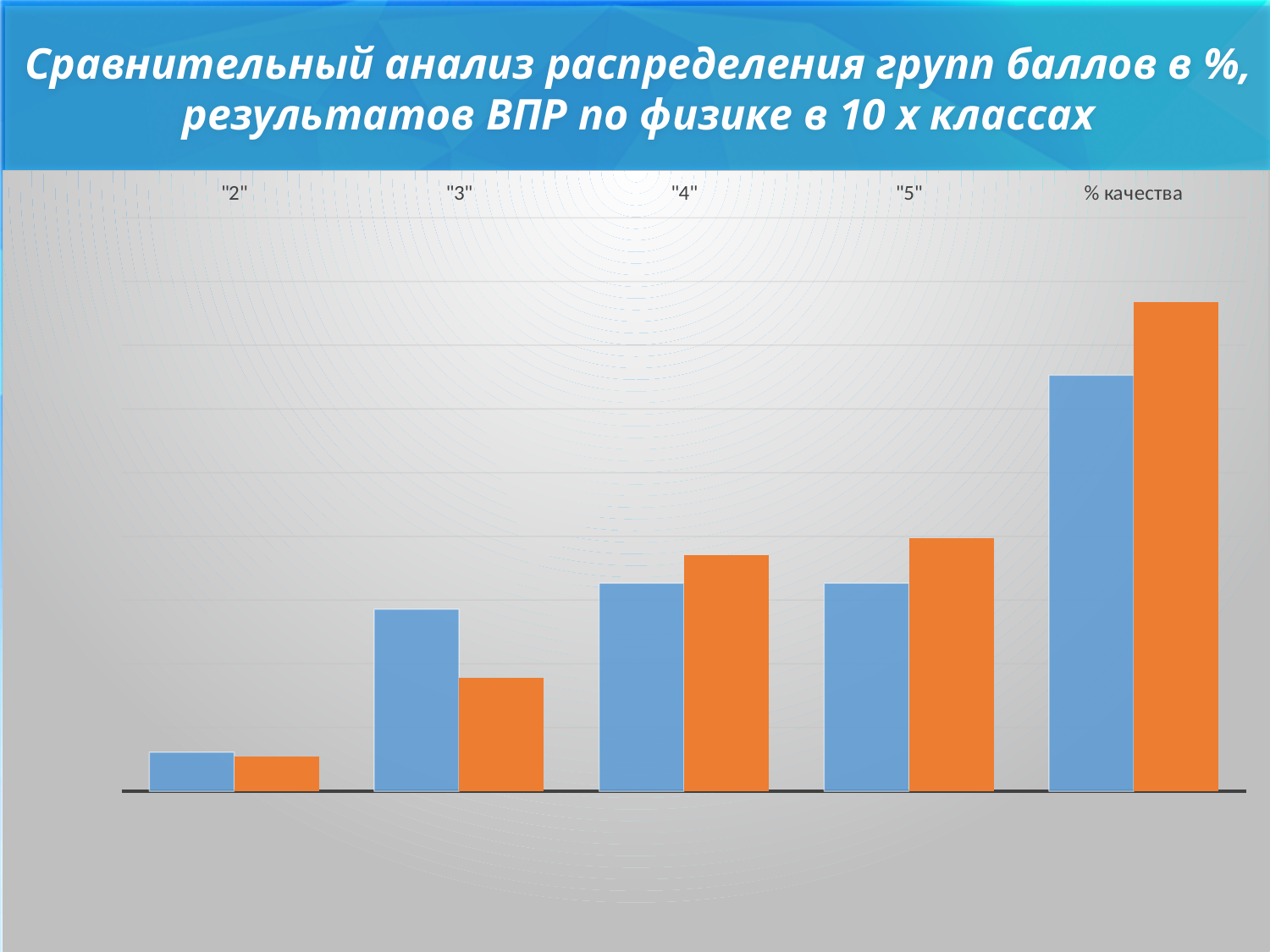
How many bars are plotted for each category in the chart? 2 For the category "% качества", which bar is taller, the blue one or the orange one? orange Which category has the tallest orange bar? % качества What kind of chart is shown on the slide? bar chart Do the orange bars rise or fall from left to right across the categories? rise How many categories are shown along the x axis of the chart? 5 What is the title of the slide containing the chart? Сравнительный анализ распределения групп баллов в %, результатов ВПР по физике в 10 х классах Which category has the shortest orange bar? "2" For the category "4", which bar is taller, the blue one or the orange one? orange Which category has the tallest blue bar? % качества For the category "3", which bar is taller, the blue one or the orange one? blue Which category has the shortest blue bar? "2"